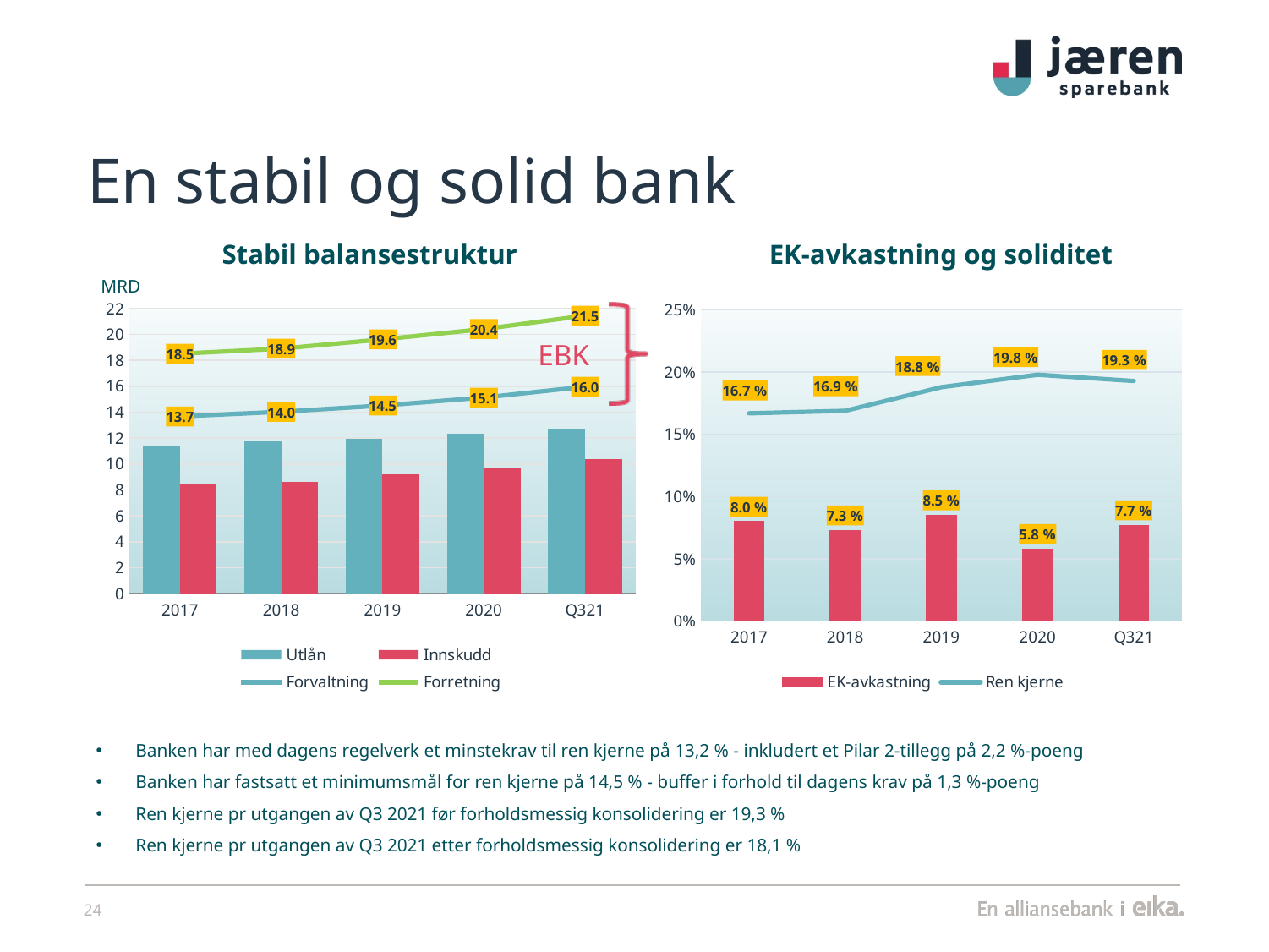
In the 'Stabil balansestruktur' chart, how many series does the legend list? 4 In the 'EK-avkastning og soliditet' chart, which period has the lowest Ren kjerne value? 2017 In the 'EK-avkastning og soliditet' chart, which year has the highest EK-avkastning? 2019 In the 'Stabil balansestruktur' chart, does the Forretning line rise or fall from 2017 to Q321? rise In the 'EK-avkastning og soliditet' chart, what is the EK-avkastning value for 2020? 5.8 % In the 'Stabil balansestruktur' chart, what is the Forvaltning value for 2019? 14.5 In the 'Stabil balansestruktur' chart, is the Utlån bar for 2017 greater or less than 10? greater In the 'EK-avkastning og soliditet' chart, what is the difference between the Ren kjerne values for 2019 and 2018? 1.9 % In the 'Stabil balansestruktur' chart, what is the Forretning value for Q321? 21.5 In the 'Stabil balansestruktur' chart, what is the difference between the Forretning and Forvaltning values in 2017? 4.8 In the 'EK-avkastning og soliditet' chart, is Ren kjerne higher in 2020 or in Q321? 2020 In the 'EK-avkastning og soliditet' chart, how many periods are shown on the x axis? 5